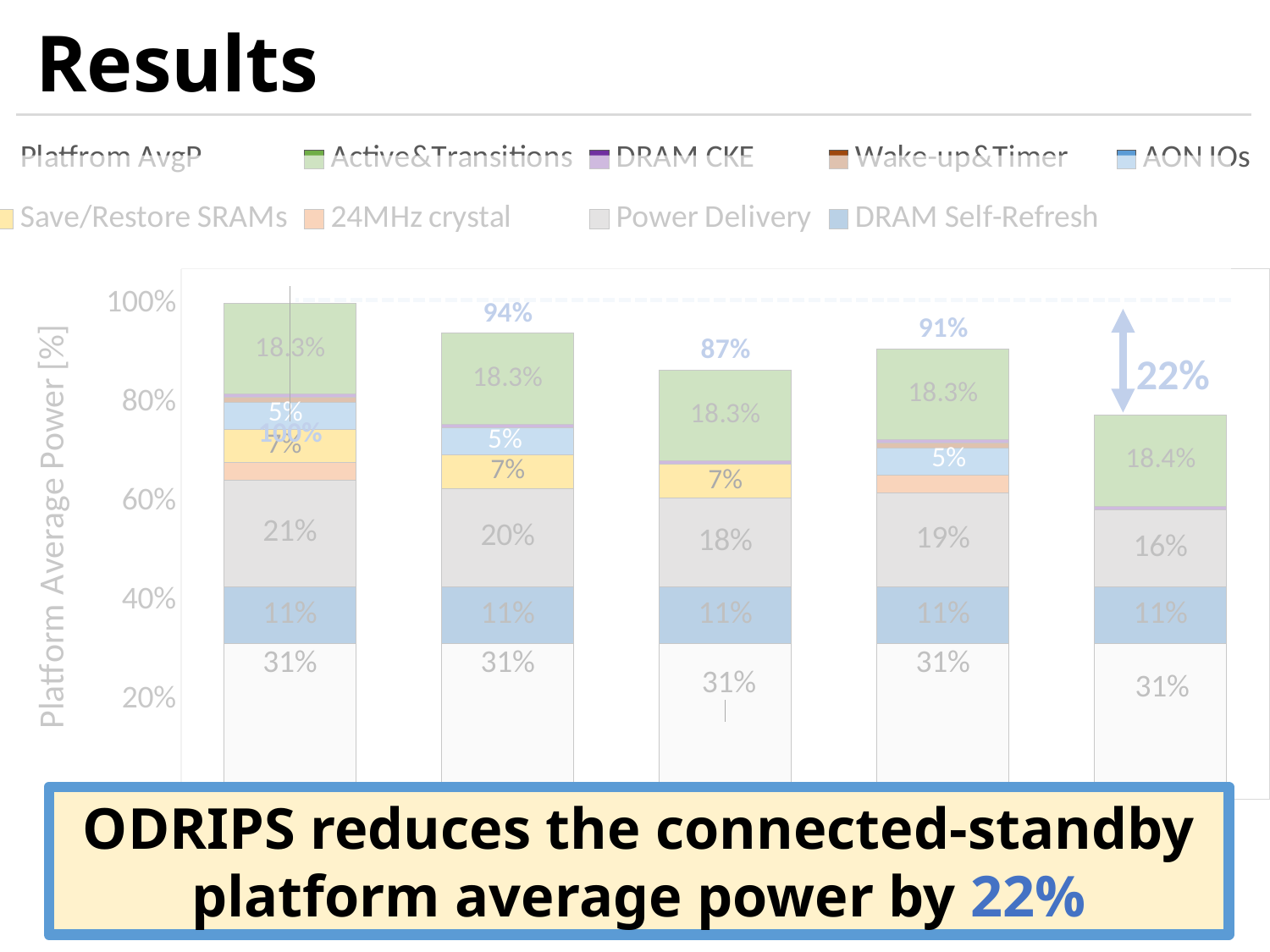
How many bars are plotted in the chart? 5 Which bar has the lowest Power Delivery value? The rightmost bar (16%) How many entries does the chart legend list? 9 What total percentage is labelled above the middle (third) bar? 87% What is the Power Delivery value labelled in the rightmost bar? 16% What kind of chart is shown on the slide? Stacked bar chart What is the difference between the Power Delivery value in the leftmost bar and in the rightmost bar? 5 percentage points What is the Active&Transitions value labelled in the rightmost bar? 18.4% What is the label on the y axis of the chart? Platform Average Power [%] What is the Power Delivery value labelled in the leftmost bar? 21% What total percentage is labelled above the second bar from the left? 94% Is the Power Delivery value larger in the second bar or in the fourth bar? The second bar (20%)